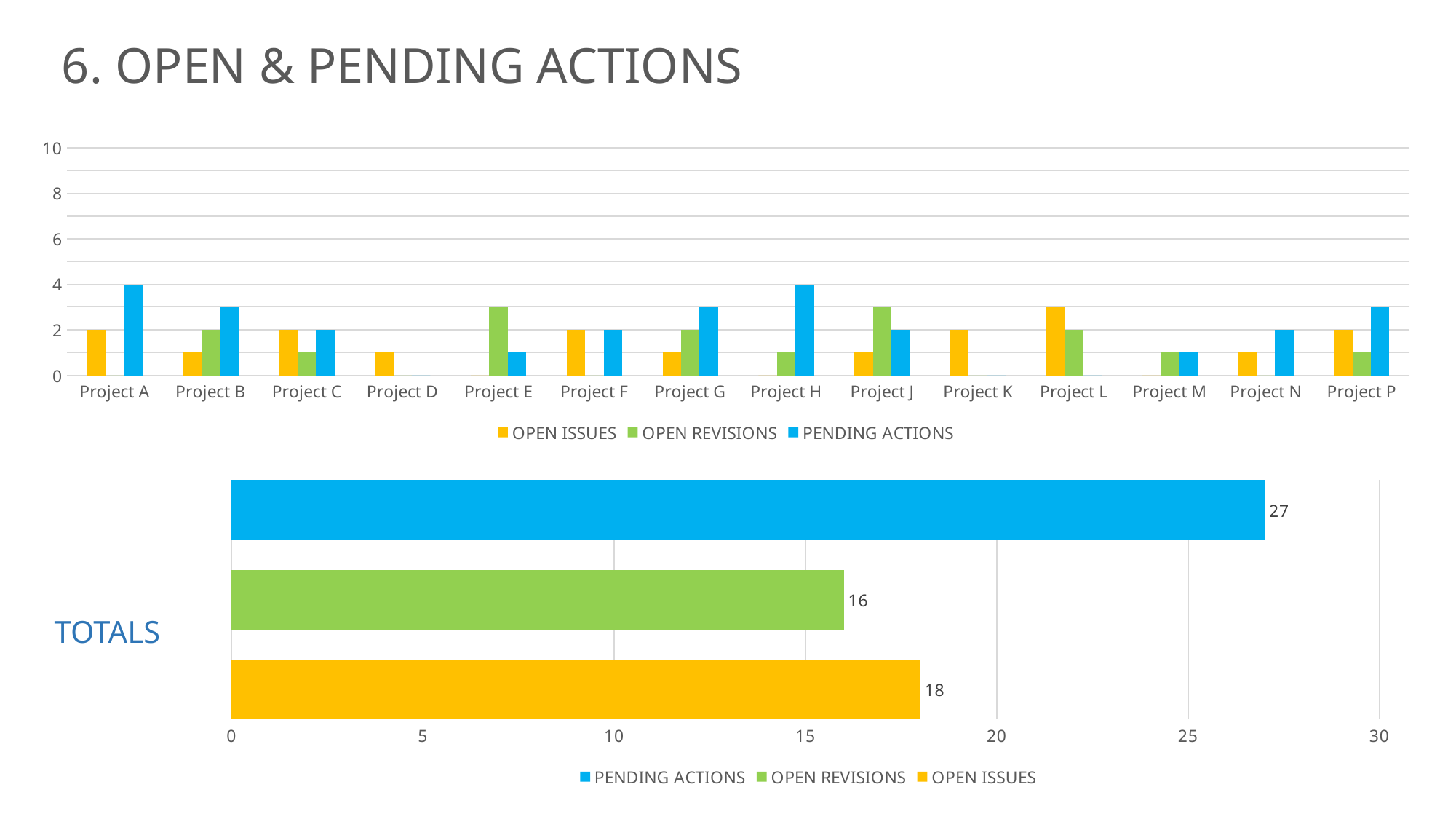
In the bottom TOTALS chart, what is the value for OPEN ISSUES? 18 In the top chart, what is the PENDING ACTIONS value for Project A? 4 In the top chart, how many series does the legend list? 3 What kind of chart is the bottom TOTALS chart? bar chart In the bottom TOTALS chart, what is the value for OPEN REVISIONS? 16 In the bottom TOTALS chart, which category has the lowest value? OPEN REVISIONS In the top chart, which is larger for Project H: OPEN REVISIONS or PENDING ACTIONS? PENDING ACTIONS In the bottom TOTALS chart, what is the value for PENDING ACTIONS? 27 In the bottom TOTALS chart, what is the difference between PENDING ACTIONS and OPEN ISSUES? 9 In the top chart, how many projects are shown on the x axis? 14 In the bottom TOTALS chart, which category has the highest value? PENDING ACTIONS In the bottom TOTALS chart, is the value for PENDING ACTIONS greater or less than 25? greater